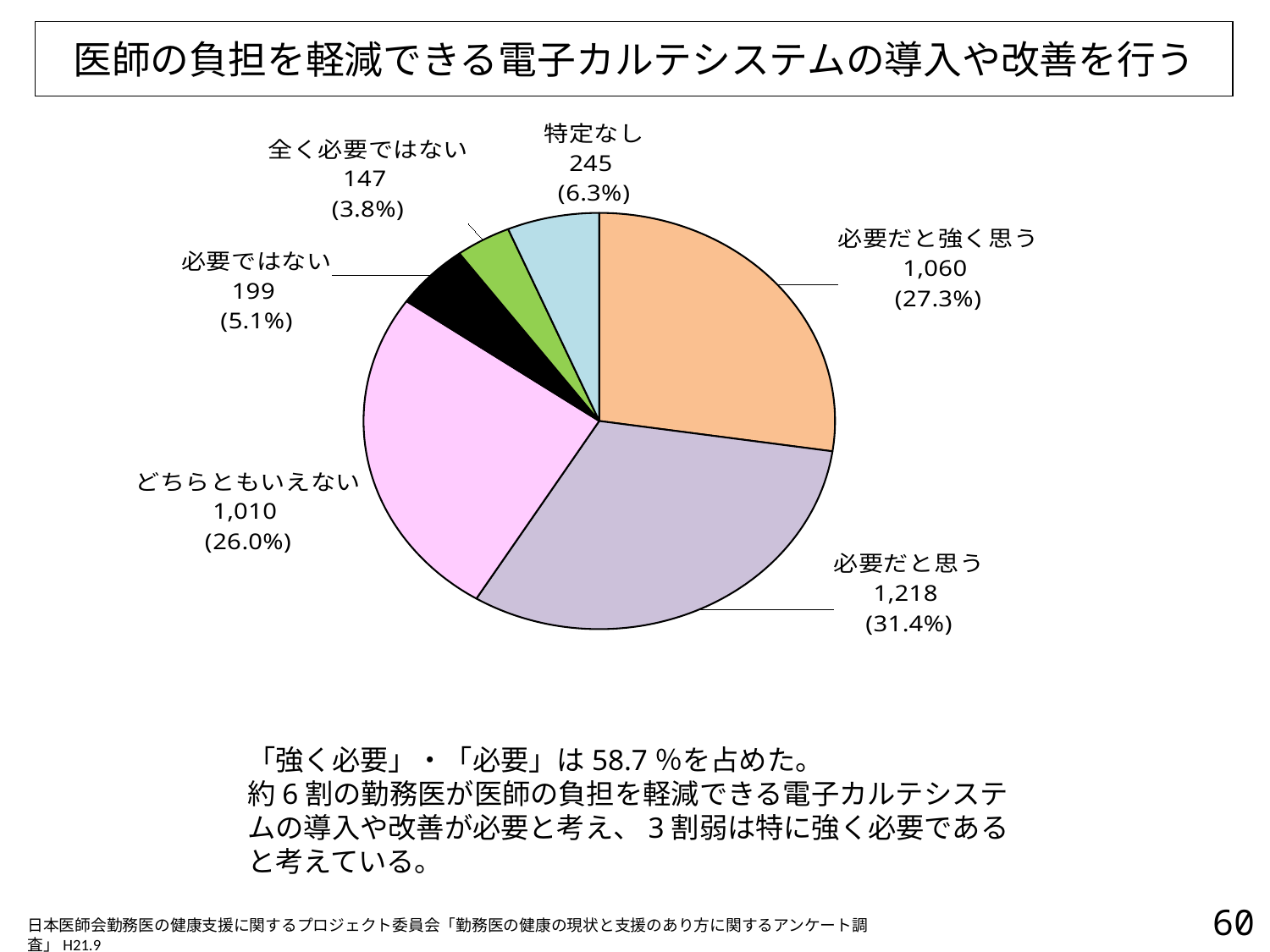
What share of the pie does 特定なし represent? 6.3% Which is larger, the value for 必要ではない or the value for 特定なし? 特定なし Which category has the largest slice? 必要だと思う What is the title of the chart? 医師の負担を軽減できる電子カルテシステムの導入や改善を行う What type of chart is shown on the slide? pie chart What is the difference between the values for 必要だと思う and 必要だと強く思う? 158 What is the value for 必要だと思う? 1,218 What is the value for 必要だと強く思う? 1,060 Which category has the smallest slice? 全く必要ではない How many slices does the pie chart have? 6 What is the value for 全く必要ではない? 147 What share of the pie does どちらともいえない represent? 26.0%